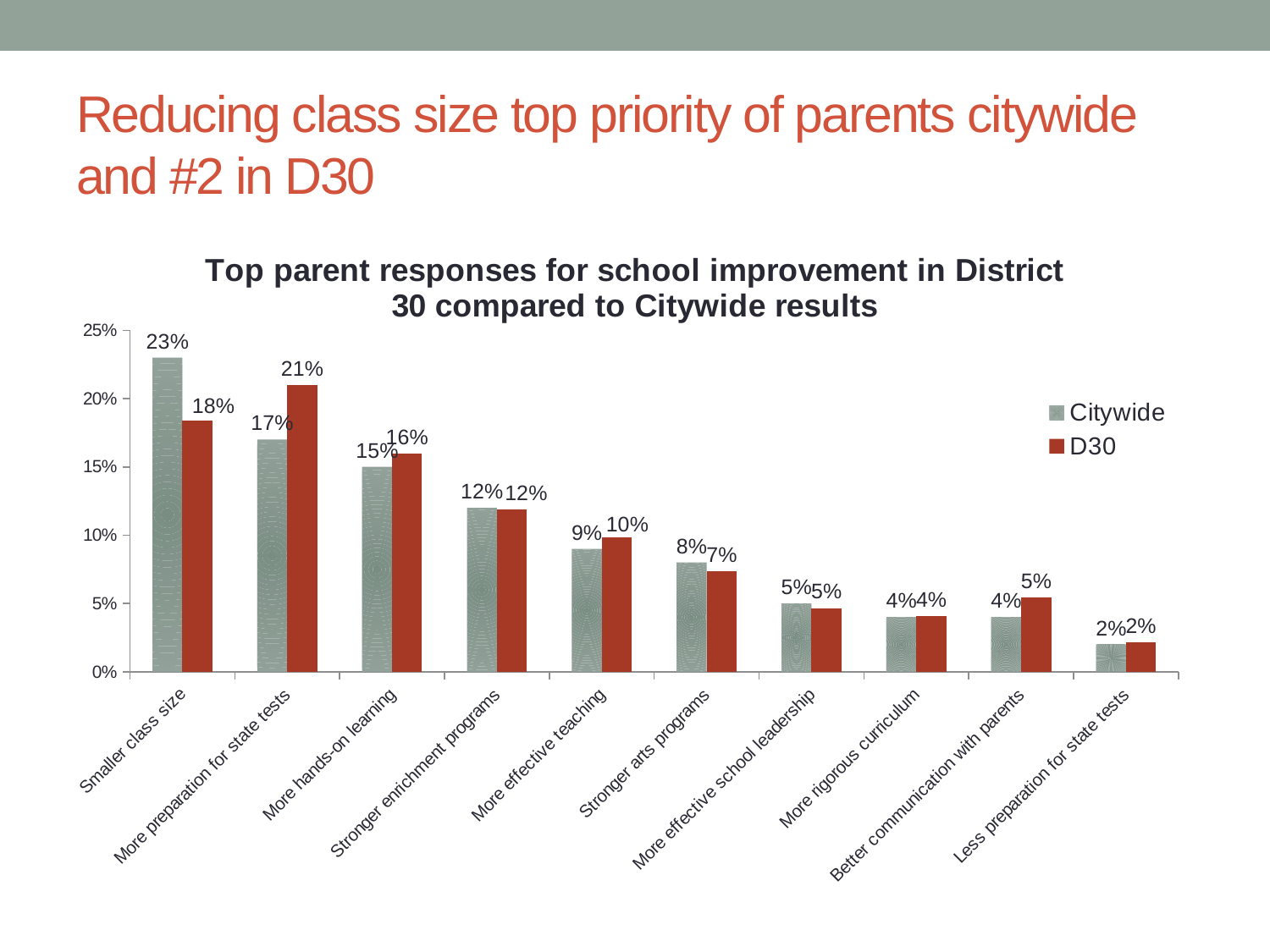
What is the D30 value for More effective teaching? 10% What is the D30 value for More preparation for state tests? 21% Do the Citywide values generally rise or fall from left to right along the x axis? Fall What kind of chart is shown on the slide? Bar chart Which is larger for More preparation for state tests, the Citywide value or the D30 value? D30 How many series does the legend list? 2 What is the Citywide value for Smaller class size? 23% Which category has the lowest Citywide value? Less preparation for state tests Which category has the highest D30 value? More preparation for state tests How many categories are shown on the x axis? 10 What is the title of the chart? Top parent responses for school improvement in District 30 compared to Citywide results What is the difference between the Citywide and D30 values for Smaller class size? 5%